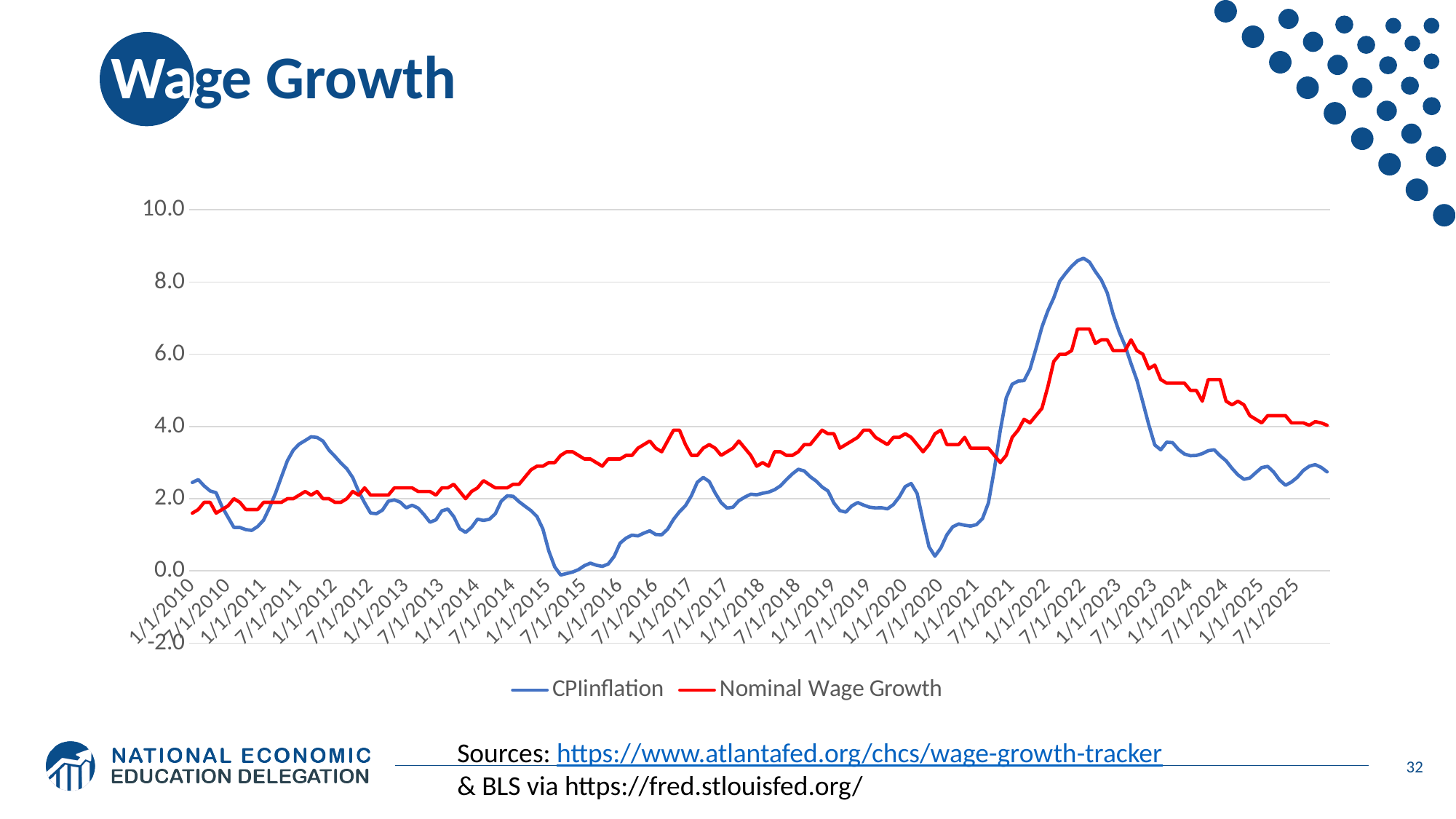
Is the peak value of CPIinflation around 7/1/2022 greater or less than 8.0? greater Is the peak value of Nominal Wage Growth in 2022 greater or less than 6.0? greater At 1/1/2024, which series has the higher value, CPIinflation or Nominal Wage Growth? Nominal Wage Growth What is the title of the slide containing the chart? Wage Growth At 7/1/2022, which series has the higher value, CPIinflation or Nominal Wage Growth? CPIinflation How many series does the legend list? 2 Which series reaches the highest value anywhere on the chart? CPIinflation Which series reaches the lowest value anywhere on the chart? CPIinflation Is the value of CPIinflation around 7/1/2015 greater or less than 2.0? less What are the two series named in the legend? CPIinflation and Nominal Wage Growth Does CPIinflation rise or fall between 7/1/2022 and 7/1/2023? fall What kind of chart is shown on the slide? line chart